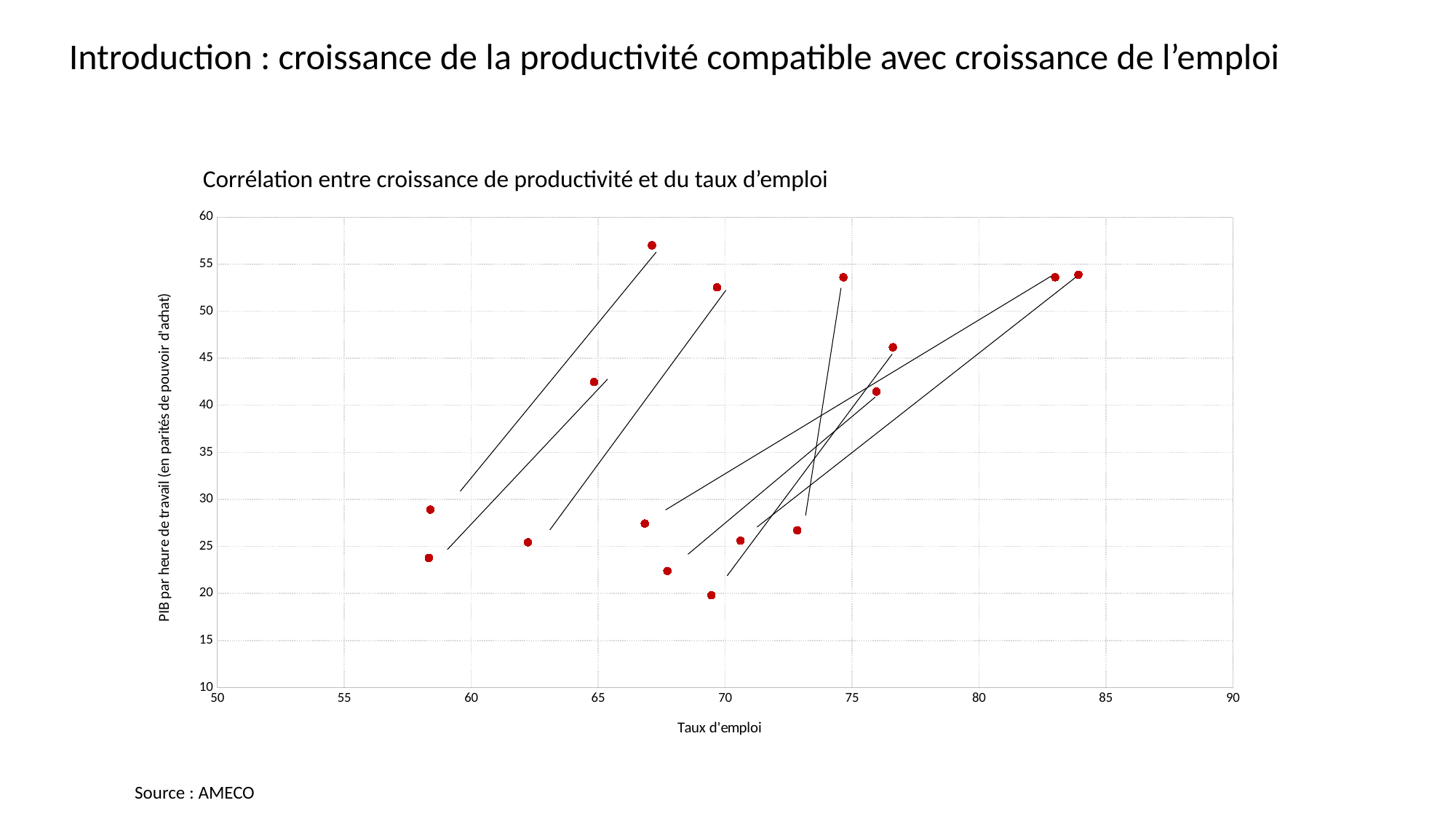
What kind of chart is shown on the slide? Scatter chart Do the plotted values generally rise or fall as the employment rate increases along the x axis? rise What is the minimum value shown on the vertical axis of the chart? 10 How many data points are plotted on the chart? 16 Is the lowest plotted value on the vertical axis greater or less than 25? less Is the largest employment rate (Taux d'emploi) plotted greater or less than 80? greater What is the maximum value shown on the horizontal axis of the chart? 90 Is the highest plotted value on the vertical axis greater or less than 55? greater What is the label of the horizontal axis of the chart? Taux d'emploi